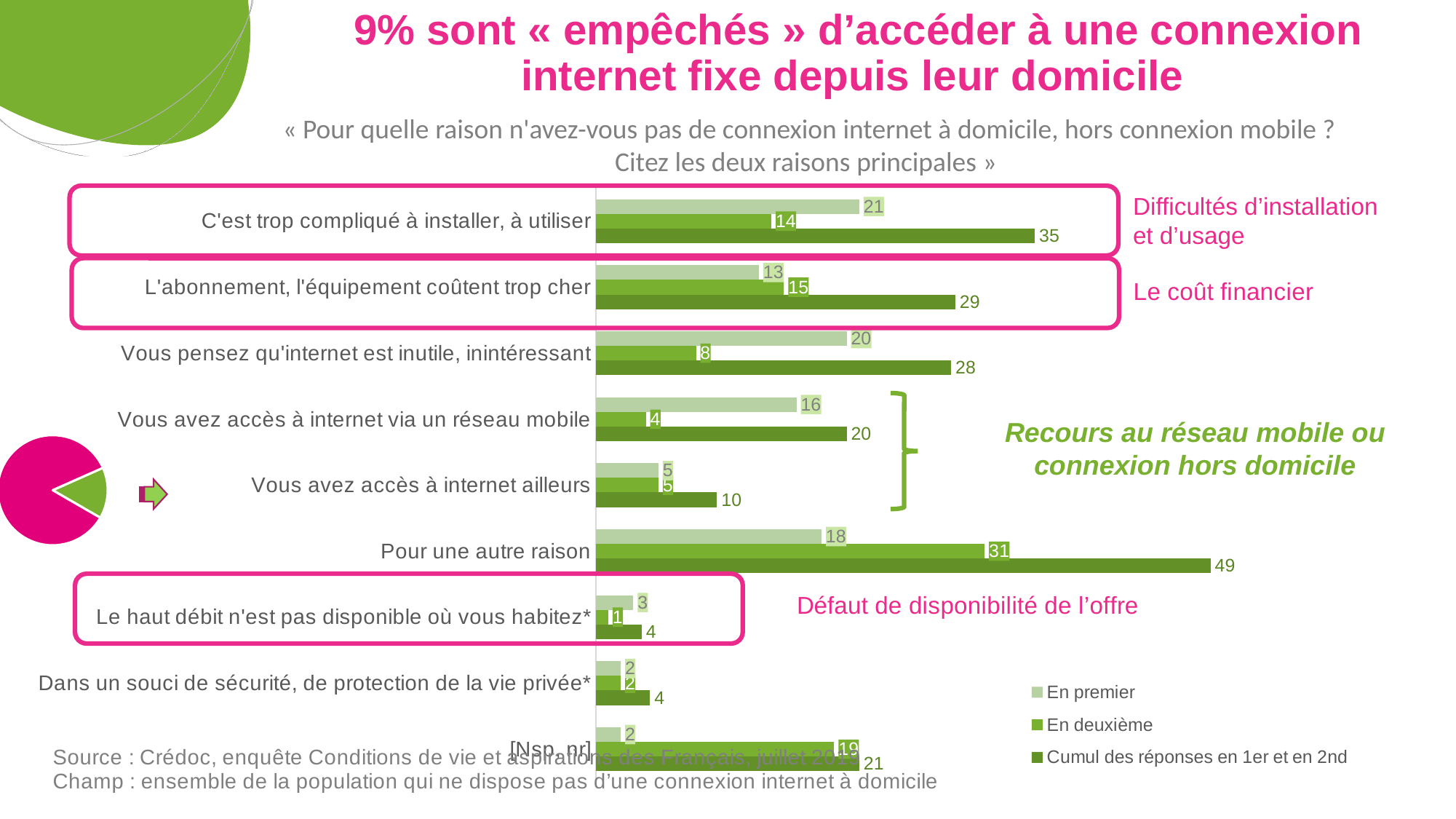
Which is larger: the 'En premier' value for 'Vous pensez qu'internet est inutile, inintéressant' or the 'En premier' value for 'Vous avez accès à internet via un réseau mobile'? Vous pensez qu'internet est inutile, inintéressant What is the 'En premier' value for 'L'abonnement, l'équipement coûtent trop cher'? 13 What is the 'En deuxième' value for 'Pour une autre raison'? 31 Which category has the highest 'Cumul des réponses en 1er et en 2nd' value? Pour une autre raison What is the difference between the 'Cumul des réponses en 1er et en 2nd' values for 'C'est trop compliqué à installer, à utiliser' and 'L'abonnement, l'équipement coûtent trop cher'? 6 Which legend entry is shown in the darkest green? Cumul des réponses en 1er et en 2nd How many series does the legend list? 3 What is the 'En deuxième' value for '[Nsp, nr]'? 19 Which category has the lowest 'En deuxième' value? Le haut débit n'est pas disponible où vous habitez* How many categories are shown on the chart? 9 What kind of chart is shown on the slide? Bar chart What is the 'Cumul des réponses en 1er et en 2nd' value for 'C'est trop compliqué à installer, à utiliser'? 35